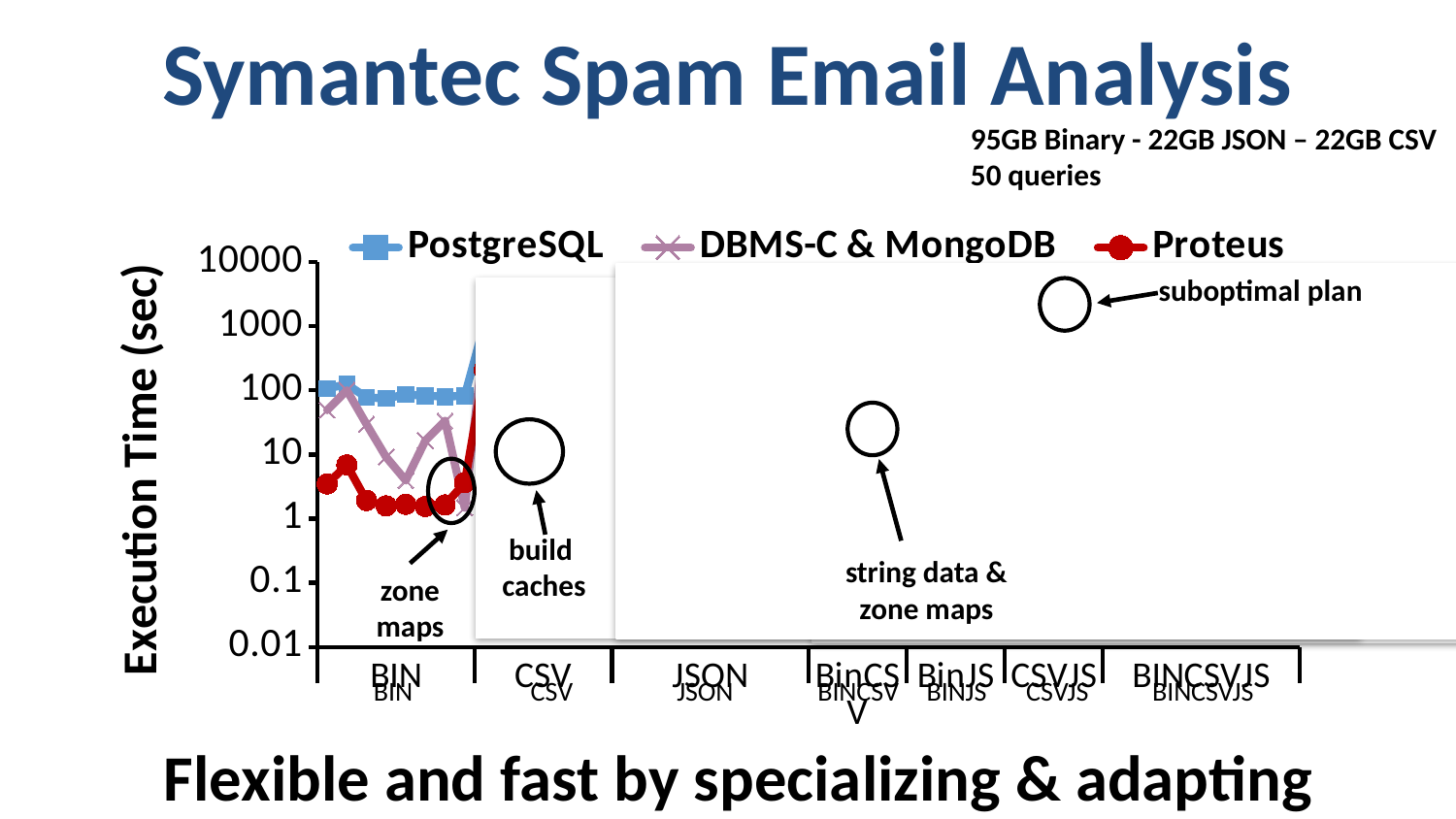
How many series does the chart legend list? 3 What is the lowest tick value shown on the y axis? 0.01 What kind of chart is shown on the slide? line chart What is the highest tick value shown on the y axis? 10000 How many categories are labelled along the x axis? 7 In the BIN section, which series has the lowest execution times? Proteus In the BIN section, are the PostgreSQL execution times greater or less than 10 seconds? greater In the BIN section, are the Proteus execution times greater or less than 10 seconds? less Which series are listed in the chart legend? PostgreSQL, DBMS-C & MongoDB, Proteus In the BIN section, which series has the higher execution times, PostgreSQL or Proteus? PostgreSQL What is the label of the y axis? Execution Time (sec) In the BIN section, are the Proteus execution times greater or less than 1 second? greater